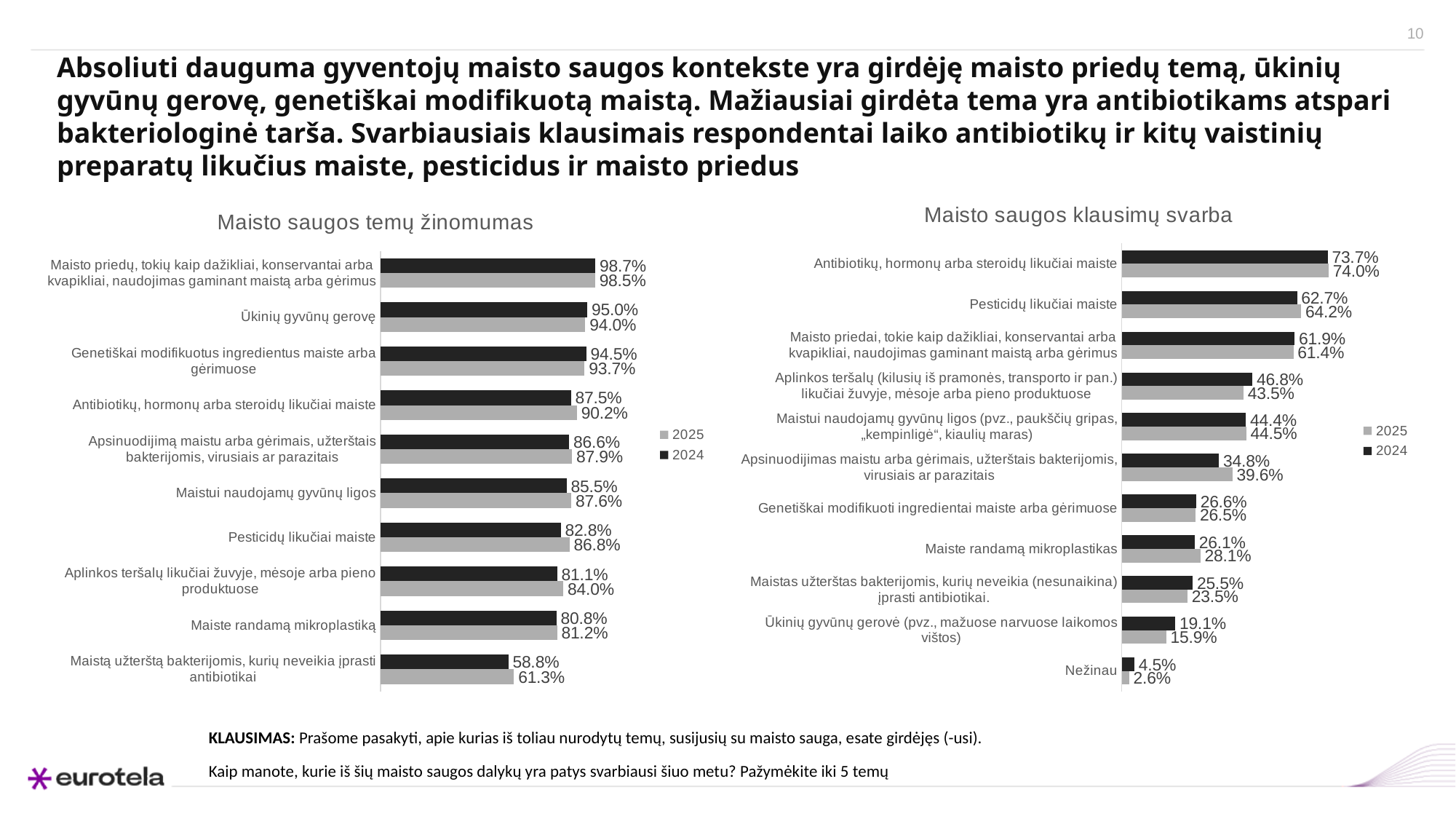
In the chart 'Maisto saugos klausimų svarba', which category has the highest 2024 value? Antibiotikų, hormonų arba steroidų likučiai maiste What type of chart is 'Maisto saugos temų žinomumas'? Bar chart In the chart 'Maisto saugos temų žinomumas', what is the 2025 value for 'Pesticidų likučiai maiste'? 86.8% In the chart 'Maisto saugos temų žinomumas', what is the 2024 value for 'Maiste randamą mikroplastiką'? 80.8% In the chart 'Maisto saugos klausimų svarba', what is the 2024 value for 'Nežinau'? 4.5% In the chart 'Maisto saugos klausimų svarba', is the 2024 value for 'Pesticidų likučiai maiste' larger or smaller than the 2025 value? smaller In the chart 'Maisto saugos temų žinomumas', what is the difference between the 2025 and 2024 values for 'Antibiotikų, hormonų arba steroidų likučiai maiste'? 2.7% In the chart 'Maisto saugos temų žinomumas', which category has the lowest 2025 value? Maistą užterštą bakterijomis, kurių neveikia įprasti antibiotikai In the chart 'Maisto saugos temų žinomumas', how many categories are shown? 10 In the chart 'Maisto saugos klausimų svarba', what is the 2025 value for 'Apsinuodijimas maistu arba gėrimais, užterštais bakterijomis, virusiais ar parazitais'? 39.6% How many series does the legend of the chart 'Maisto saugos klausimų svarba' list? 2 In the chart 'Maisto saugos klausimų svarba', what is the difference between the 2024 and 2025 values for 'Ūkinių gyvūnų gerovė (pvz., mažuose narvuose laikomos vištos)'? 3.2%